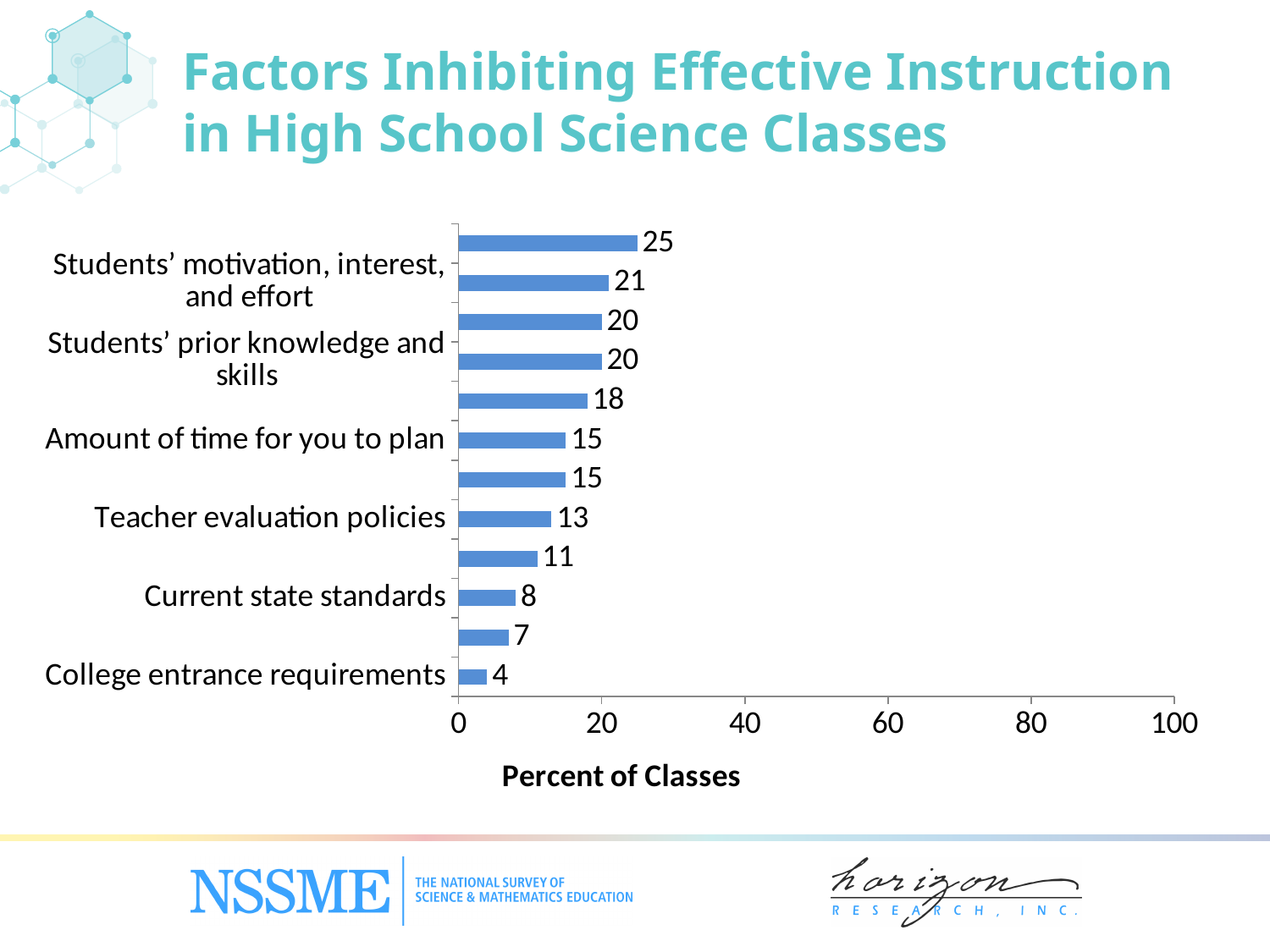
Which is larger, the value for Teacher evaluation policies or the value for Amount of time for you to plan? Amount of time for you to plan What is the value for College entrance requirements? 4 What is the value for Students' prior knowledge and skills? 20 How many bars are plotted on the chart? 12 What is the value for Students' motivation, interest, and effort? 21 What is the difference between the values for Students' motivation, interest, and effort and Current state standards? 13 What type of chart is shown on the slide? bar chart Which labeled category has the lowest value? College entrance requirements What is the value for Amount of time for you to plan? 15 What is the value for Teacher evaluation policies? 13 What is the value for Current state standards? 8 What is the highest value shown on the chart? 25